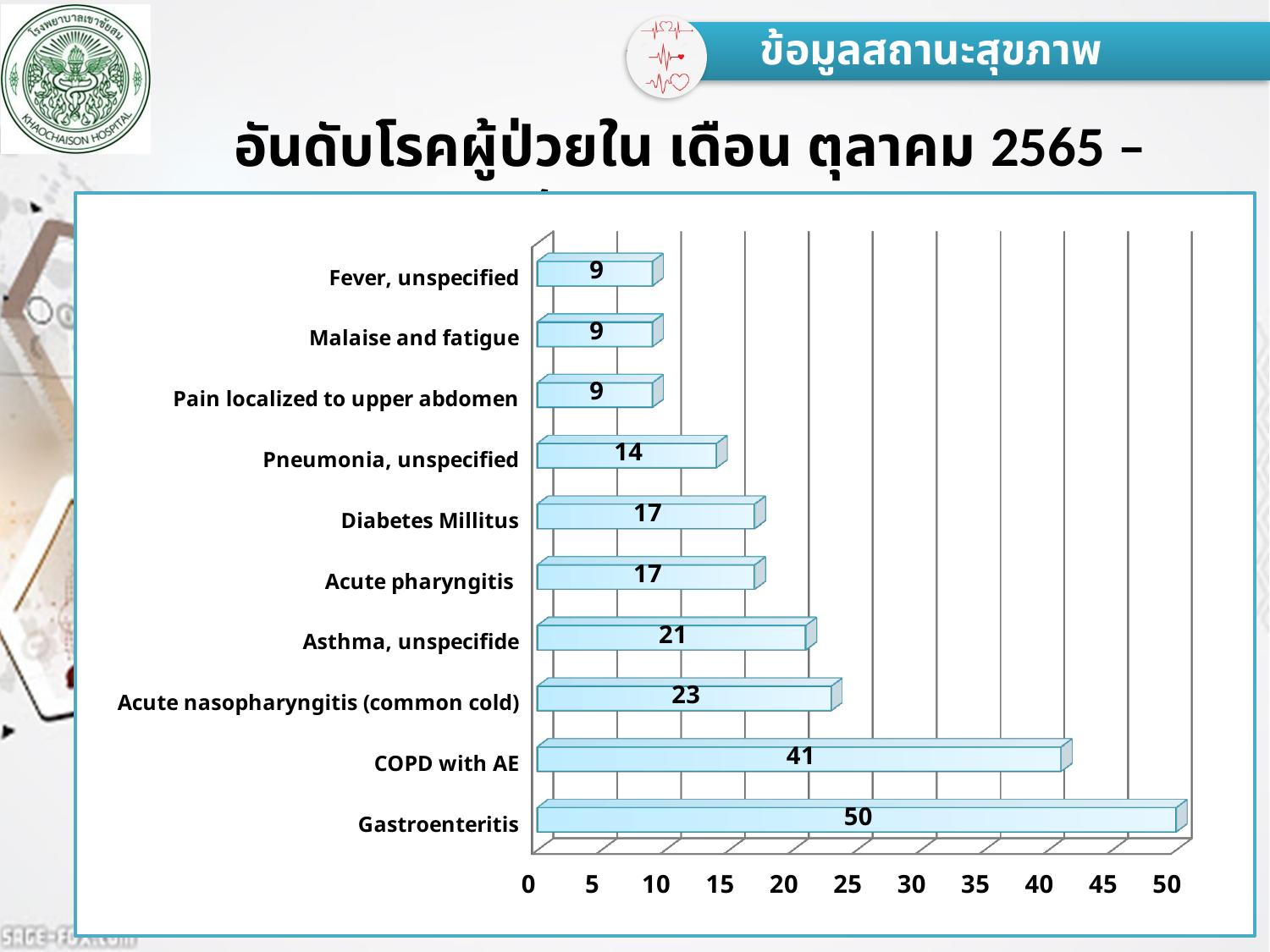
How many categories have a value of 9? 3 How many categories are shown in the chart? 10 What is the difference between the values for Asthma, unspecifide and Diabetes Millitus? 4 What is the difference between the values for Gastroenteritis and COPD with AE? 9 What is the value for Pneumonia, unspecified? 14 What is the value for Acute nasopharyngitis (common cold)? 23 What is the value for Gastroenteritis? 50 Which category has the highest value? Gastroenteritis Is the value for COPD with AE greater or less than 35? greater What kind of chart is shown on the slide? bar chart What is the value for COPD with AE? 41 Which is larger, the value for Acute nasopharyngitis (common cold) or the value for Asthma, unspecifide? Acute nasopharyngitis (common cold)